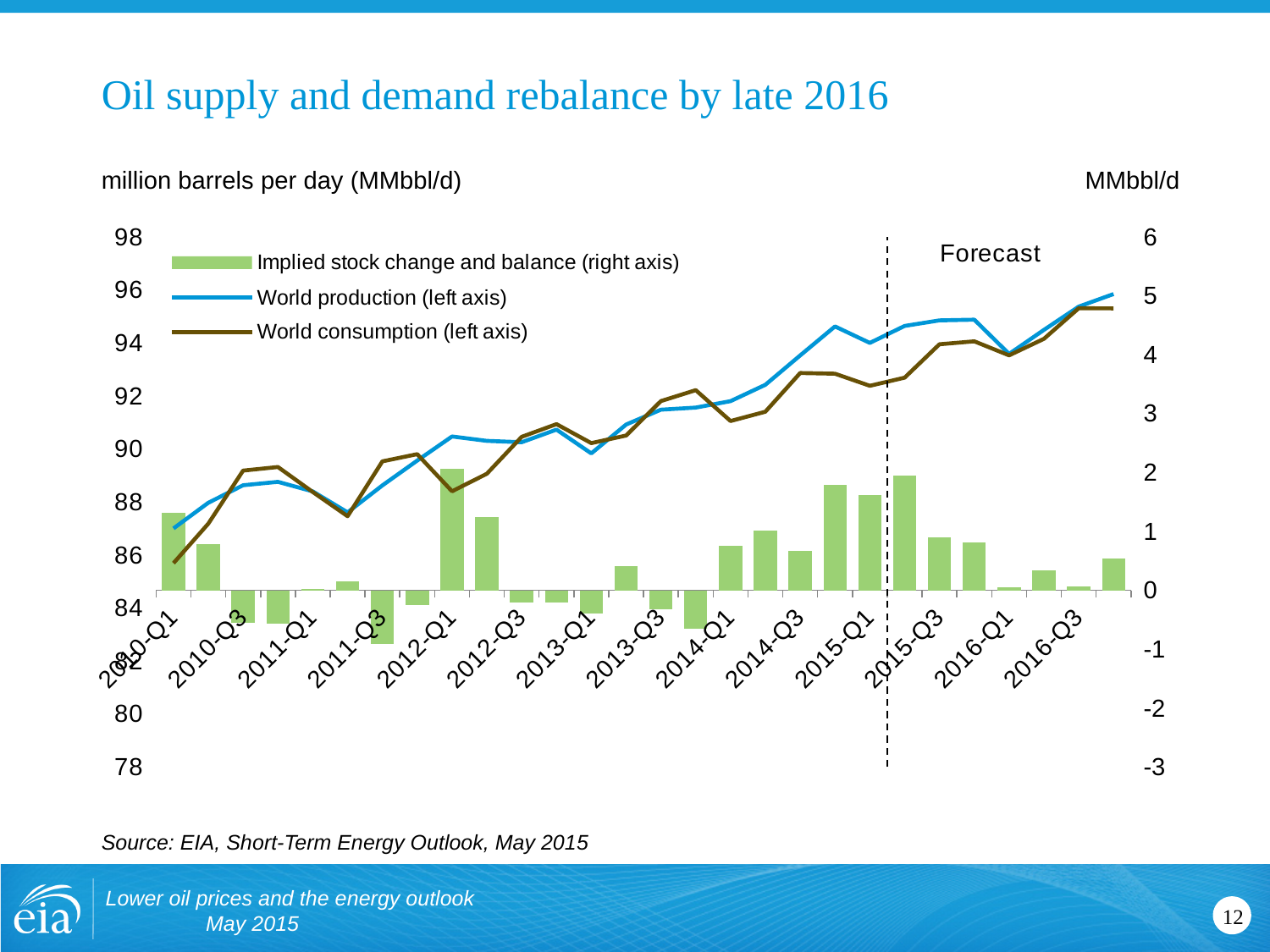
How many quarter labels are shown on the x axis? 14 Is the value for World consumption at 2013-Q1 greater or less than 92? less Is the value for World production at 2010-Q1 greater or less than 88? less How many series does the legend list? 3 Is the value for Implied stock change and balance at 2012-Q1 greater or less than 1? greater Which series is plotted on the right axis according to the legend? Implied stock change and balance What label appears to the right of the dashed vertical line? Forecast What kind of chart is shown on the slide? A combined bar and line chart Does World production generally rise or fall from 2010-Q1 to 2016-Q3? rise At 2015-Q1, which is larger, World production or World consumption? World production